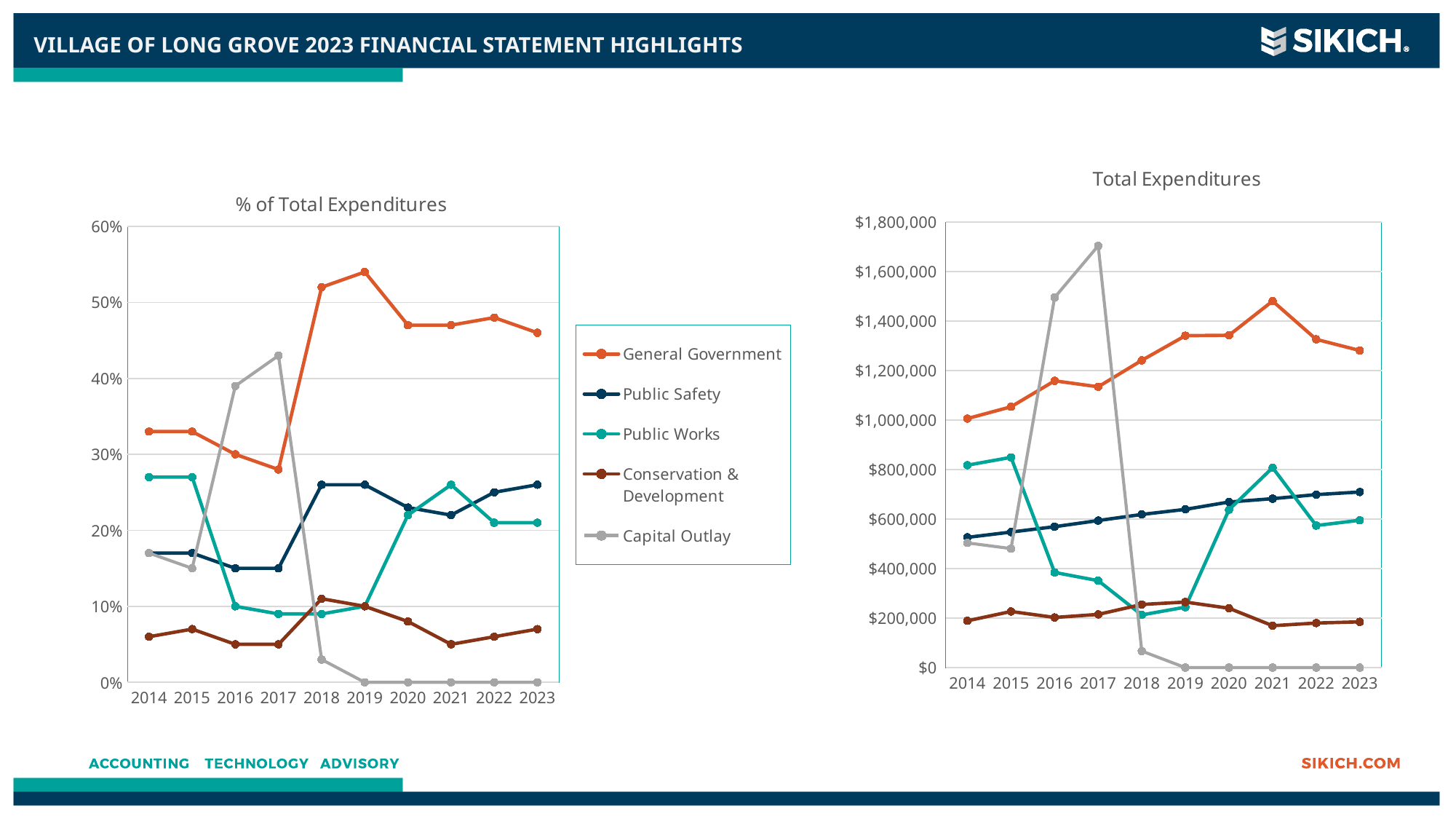
In the "Total Expenditures" chart, which series has the highest value in 2017? Capital Outlay In the "% of Total Expenditures" chart, which series has the highest value in 2019? General Government In the "Total Expenditures" chart, is the value for General Government in 2021 greater or less than $1,400,000? greater In the "% of Total Expenditures" chart, which series has the lowest value in 2021? Capital Outlay In the "% of Total Expenditures" chart, what is the value for Capital Outlay in 2023? 0% How many series does the legend list? 5 What kind of chart is the "% of Total Expenditures" chart on the left? line chart In the "Total Expenditures" chart, which is larger in 2021: Public Works or Public Safety? Public Works What colour is the General Government line in the legend? orange In the "Total Expenditures" chart, does Public Safety rise or fall from 2014 to 2023? rise How many years are shown on the x axis of the "Total Expenditures" chart? 10